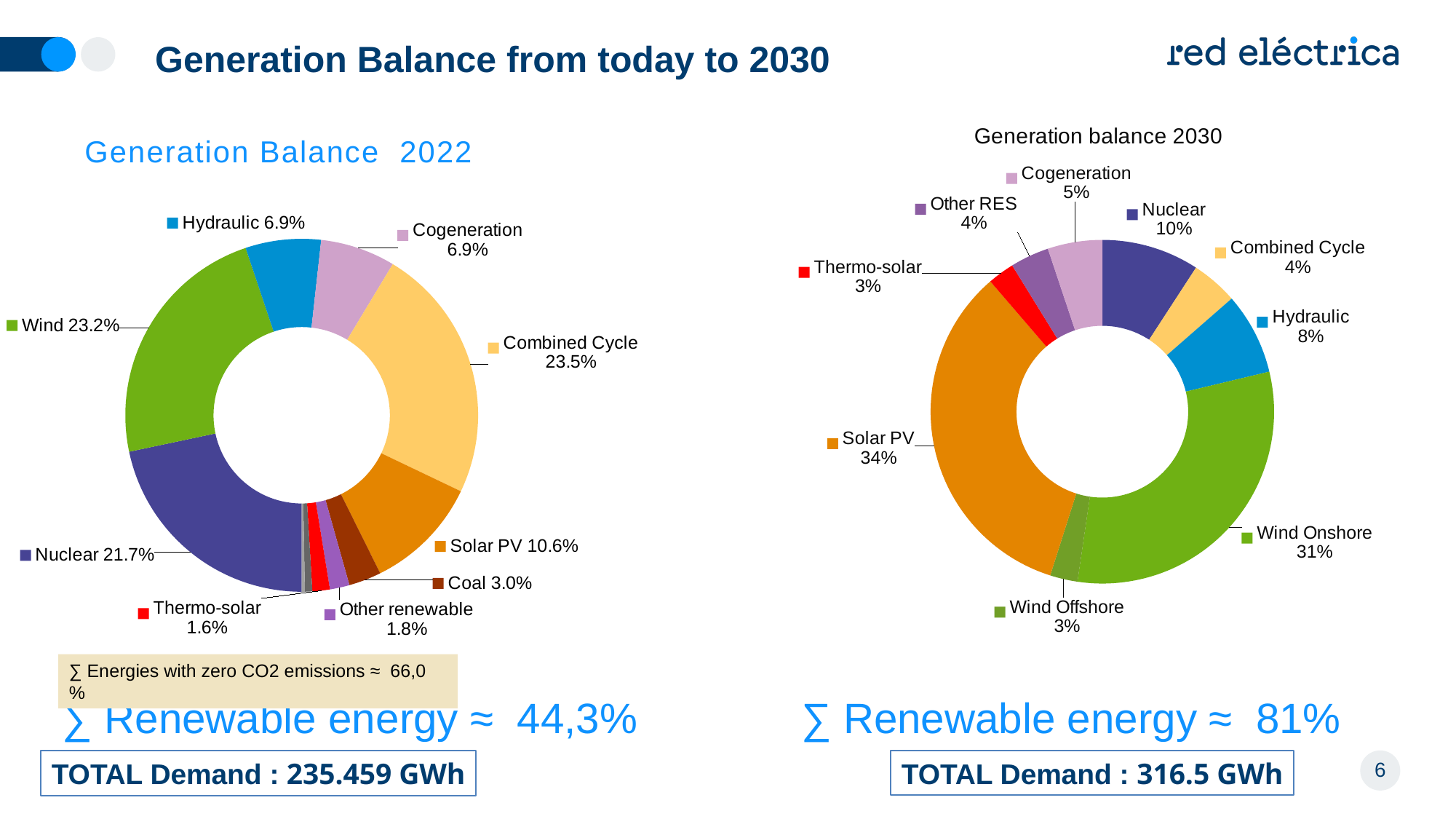
In the Generation balance 2030 chart, what share does Solar PV have? 34% In the Generation Balance 2022 chart, what share does Combined Cycle have? 23.5% In the Generation balance 2030 chart, what share does Wind Onshore have? 31% In the Generation Balance 2022 chart, which labelled category has the smallest share? Thermo-solar In the Generation Balance 2022 chart, what share does Nuclear have? 21.7% In the Generation balance 2030 chart, which category has the largest share? Solar PV In the Generation balance 2030 chart, which is larger, Cogeneration or Combined Cycle? Cogeneration How many categories are shown in the Generation balance 2030 chart? 9 In the Generation Balance 2022 chart, what is the difference between the Wind share and the Solar PV share? 12.6% In the Generation Balance 2022 chart, which is larger, Coal or Other renewable? Coal In the Generation balance 2030 chart, what is the difference between the Nuclear share and the Hydraulic share? 2% What type of chart is the Generation balance 2030 chart? Pie chart (doughnut)